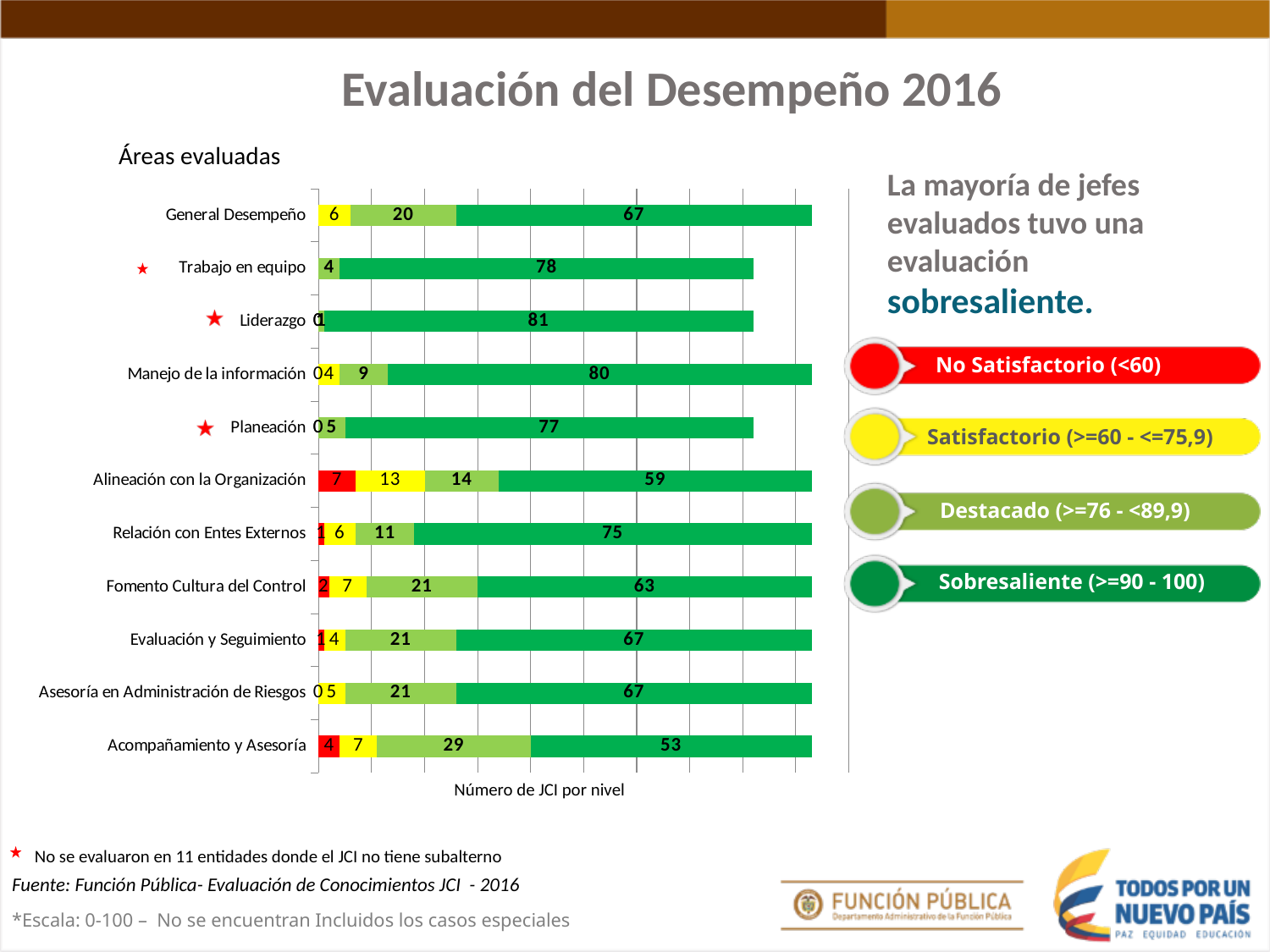
Which area has the highest number of JCI in the Sobresaliente level? Liderazgo How many areas (categories) are plotted in the chart? 11 What is the x-axis title of the chart? Número de JCI por nivel What is the difference between the Sobresaliente counts for General Desempeño and Alineación con la Organización? 8 Which area has the lowest number of JCI in the Sobresaliente level? Acompañamiento y Asesoría How many JCI are in the Sobresaliente level for Liderazgo? 81 What kind of chart is shown on the slide? bar chart Which has more JCI in the Destacado level: Fomento Cultura del Control or Alineación con la Organización? Fomento Cultura del Control What is the title shown above the chart? Áreas evaluadas How many JCI are in the Destacado level for Acompañamiento y Asesoría? 29 How many JCI are in the No Satisfactorio level for Alineación con la Organización? 7 What is the total number of JCI across all levels for Acompañamiento y Asesoría? 93